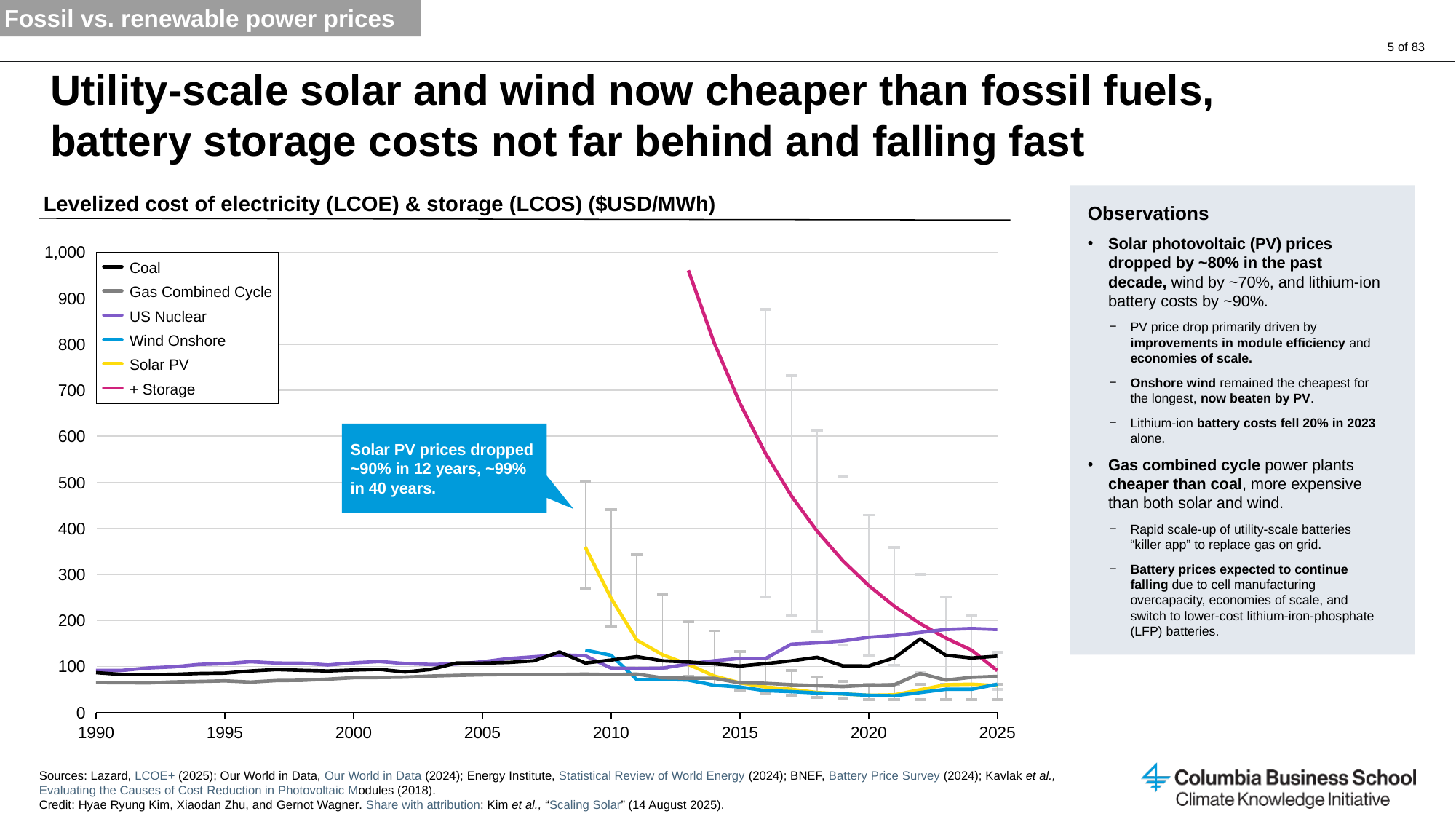
How many series does the chart's legend list? 6 Is the value for Solar PV in 2009 greater or less than 300? greater In 2025, which is higher: US Nuclear or Coal? US Nuclear What kind of chart is shown on the slide? Line chart Does the + Storage line rise or fall from 2013 to 2025? Fall What does the callout box on the chart say? Solar PV prices dropped ~90% in 12 years, ~99% in 40 years. Does the Solar PV line rise or fall from 2009 to 2025? Fall Is the value for + Storage in 2015 greater or less than 500? greater Is the value for Coal in 1990 greater or less than 200? less What is the title of the chart? Levelized cost of electricity (LCOE) & storage (LCOS) ($USD/MWh) Does the US Nuclear line rise or fall from 1990 to 2025? Rise